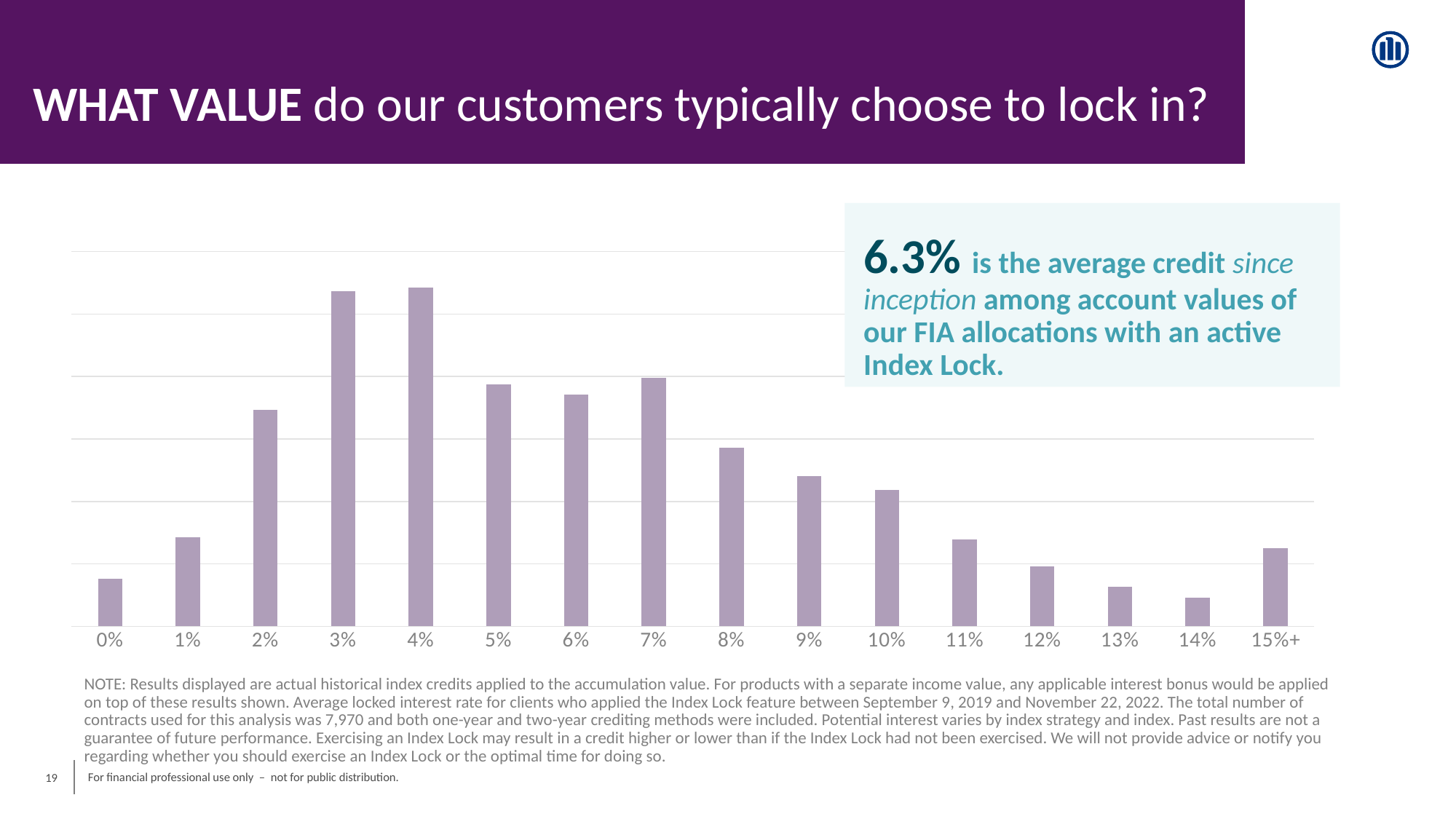
Which bar is taller, the one for 7% or the one for 8%? 7% Do the bar heights rise or fall moving from the 0% category to the 3% category? rise Which bar is taller, the one for 5% or the one for 10%? 5% Do the bar heights rise or fall moving from the 7% category to the 14% category? fall How many categories are shown along the x axis of the chart? 16 What is the last category label on the x axis of the chart? 15%+ Which bar is taller, the one for 0% or the one for 11%? 11% Which category has the lowest bar in the chart? 14% What is the first category label on the x axis of the chart? 0% What kind of chart is shown on the slide? bar chart